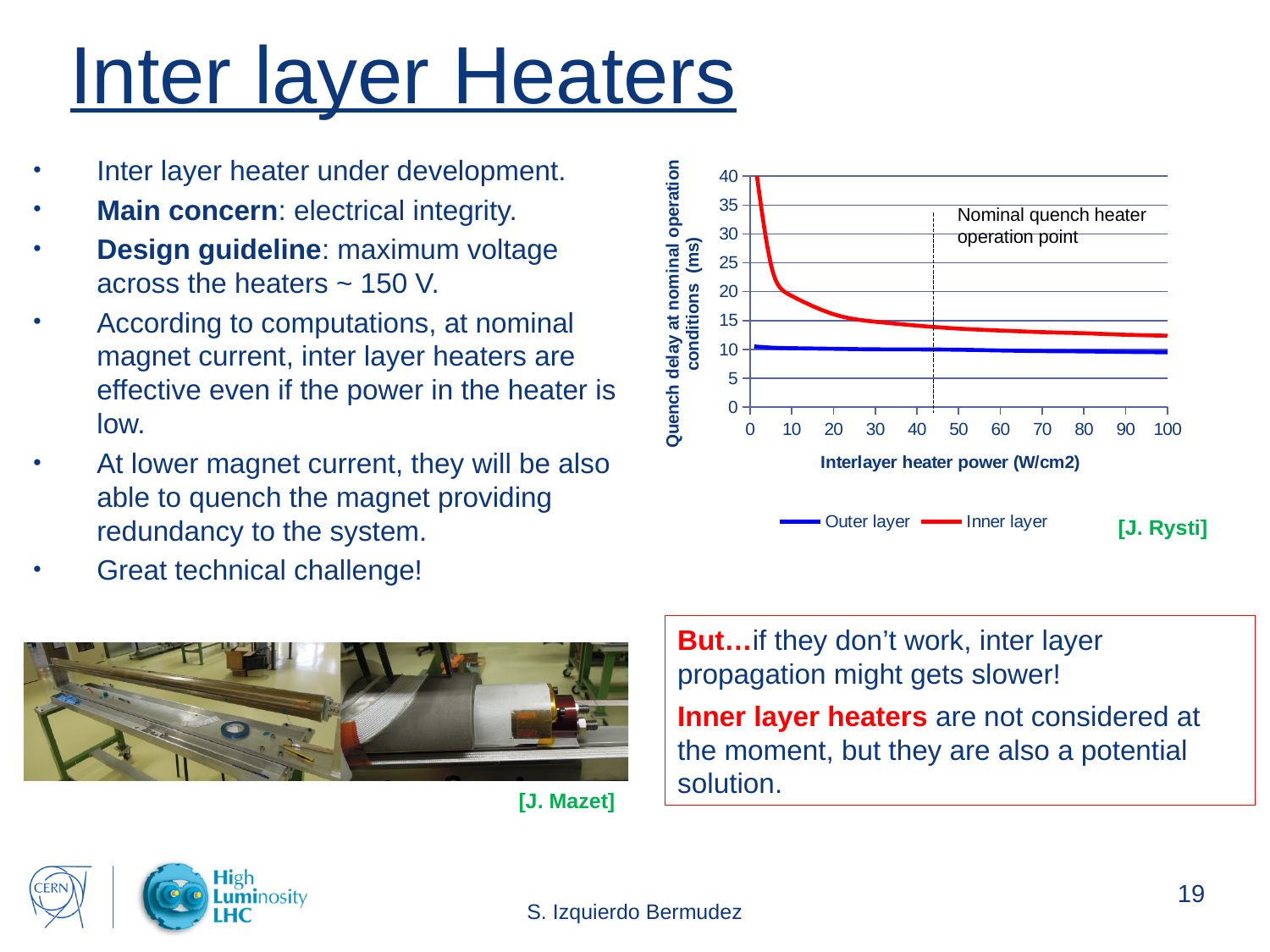
Is the quench delay for the Inner layer at 5 W/cm2 greater or less than 20 ms? greater How many series does the chart legend list? 2 Does the quench delay for the Inner layer rise or fall as the interlayer heater power increases? fall Is the quench delay for the Inner layer at 20 W/cm2 greater or less than 15 ms? greater What kind of chart is shown on the slide? line chart Which series has the higher quench delay at the lowest interlayer heater power values? Inner layer At an interlayer heater power of 50 W/cm2, which series has the larger quench delay, Outer layer or Inner layer? Inner layer What is the title of the x axis of the chart? Interlayer heater power (W/cm2) Is the quench delay for the Inner layer at 100 W/cm2 greater or less than 15 ms? less Which series is drawn in red in the chart? Inner layer